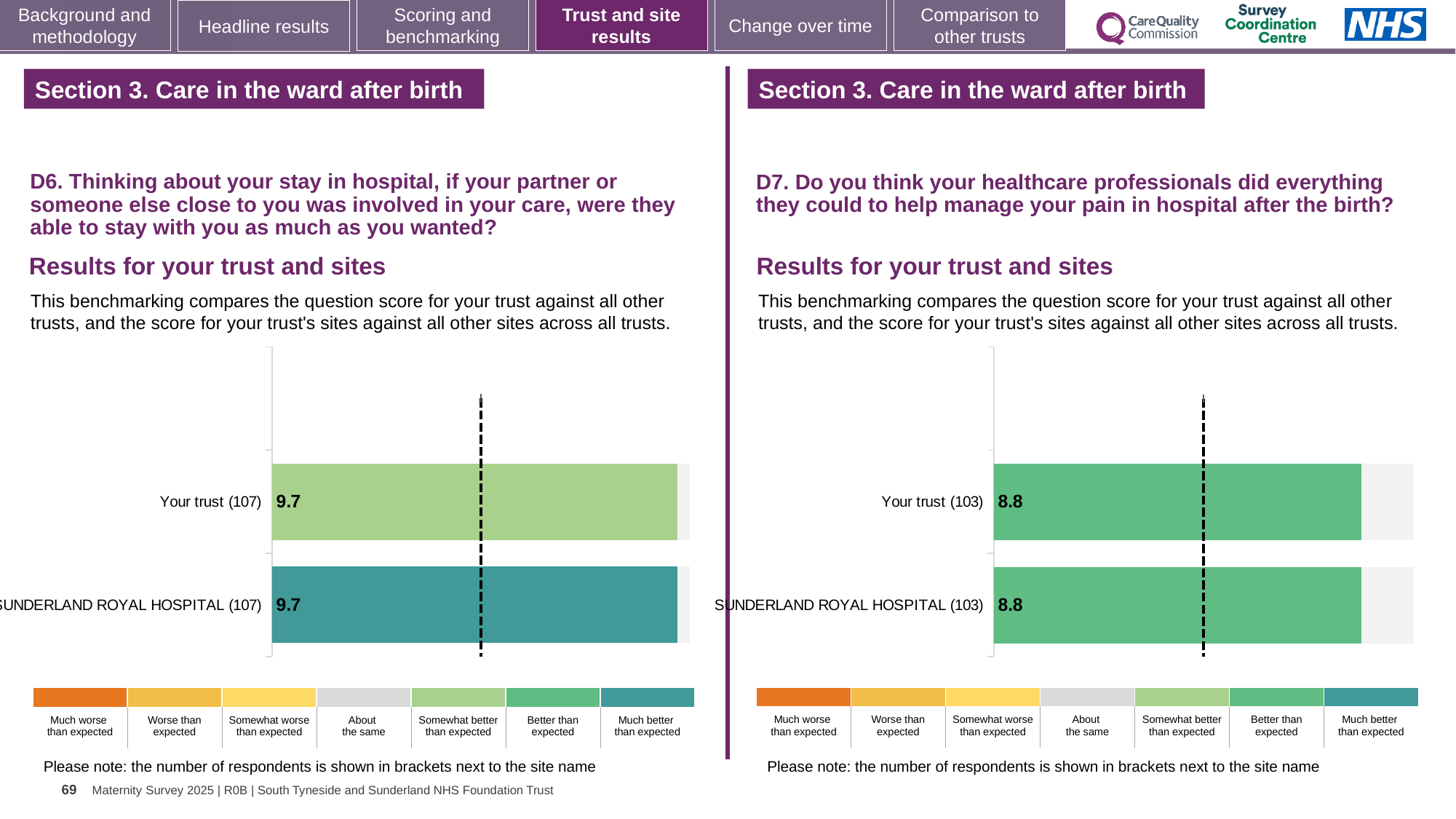
How many bars are plotted on the right chart (D7)? 2 On the left chart (D6), what is the score for Your trust? 9.7 On the left chart (D6), how many respondents are shown in brackets for Your trust? 107 How many bars are plotted on the left chart (D6)? 2 On the right chart (D7), what is the score for Your trust? 8.8 On the left chart (D6), what is the difference between the Your trust score and the SUNDERLAND ROYAL HOSPITAL score? 0.0 On the right chart (D7), what is the score for SUNDERLAND ROYAL HOSPITAL? 8.8 On the left chart (D6), what is the score for SUNDERLAND ROYAL HOSPITAL? 9.7 What kind of chart is used on the left (D6)? Bar chart On the right chart (D7), how many respondents are shown in brackets for SUNDERLAND ROYAL HOSPITAL? 103 On the right chart (D7), which benchmark category does the colour of the Your trust bar correspond to in the legend? Better than expected On the right chart (D7), what is the difference between the Your trust score and the SUNDERLAND ROYAL HOSPITAL score? 0.0